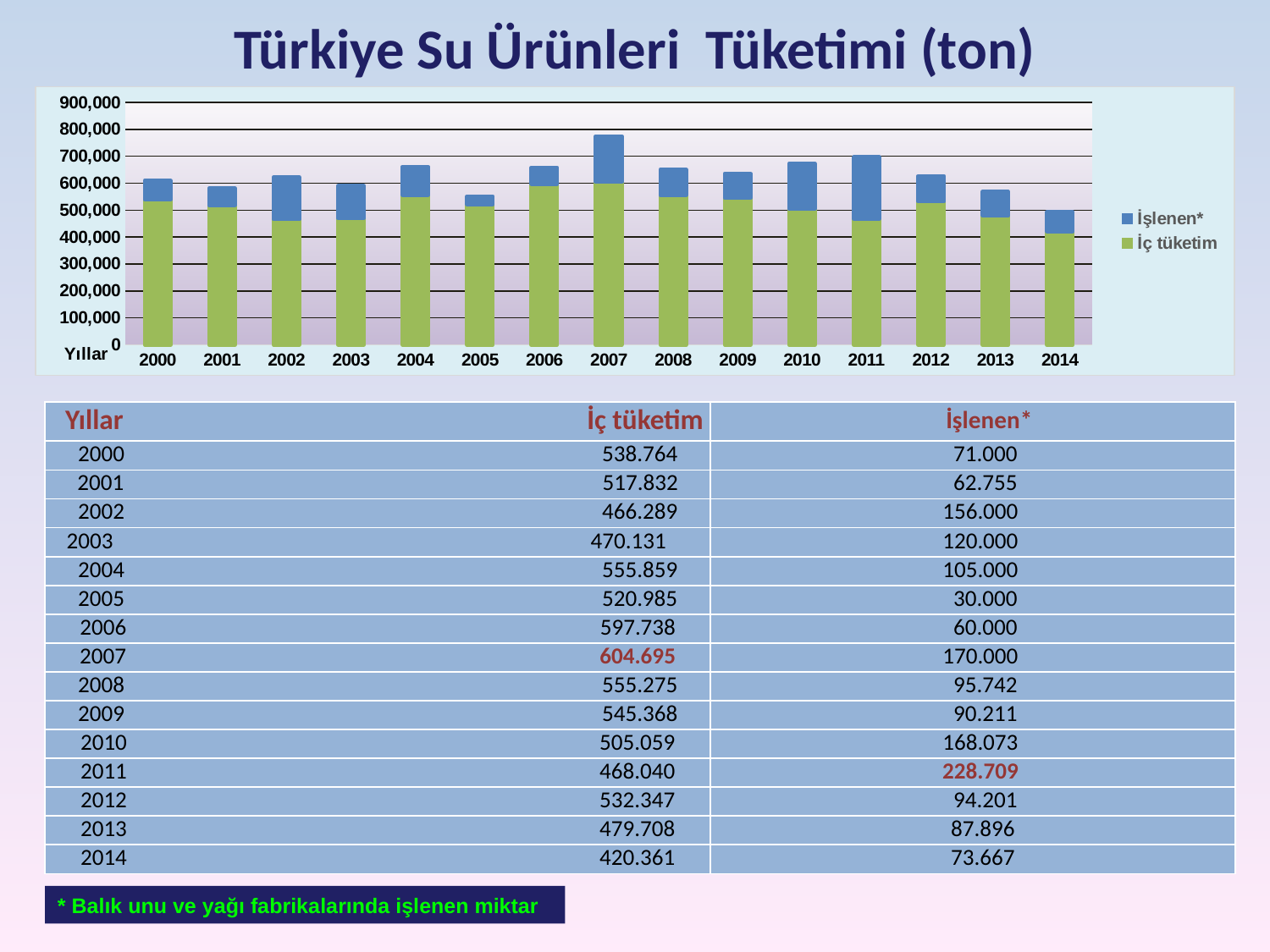
Which year has the highest İşlenen* value? 2011 What is the İşlenen* value for 2011? 228.709 Which year has the lowest İşlenen* value? 2005 What is the total of the stacked bar for 2007 (İç tüketim plus İşlenen*)? 774.695 What is the difference between the İç tüketim values for 2000 and 2014? 118.403 What is the İç tüketim value for 2007? 604.695 How many years are shown along the x axis of the chart? 15 Is the total stacked bar for 2014 greater or less than 600,000? less Which is larger, the İşlenen* value for 2002 or for 2003? 2002 Which year has the lowest İç tüketim value? 2014 How many series does the chart legend list? 2 What kind of chart is shown on the slide? Stacked bar chart